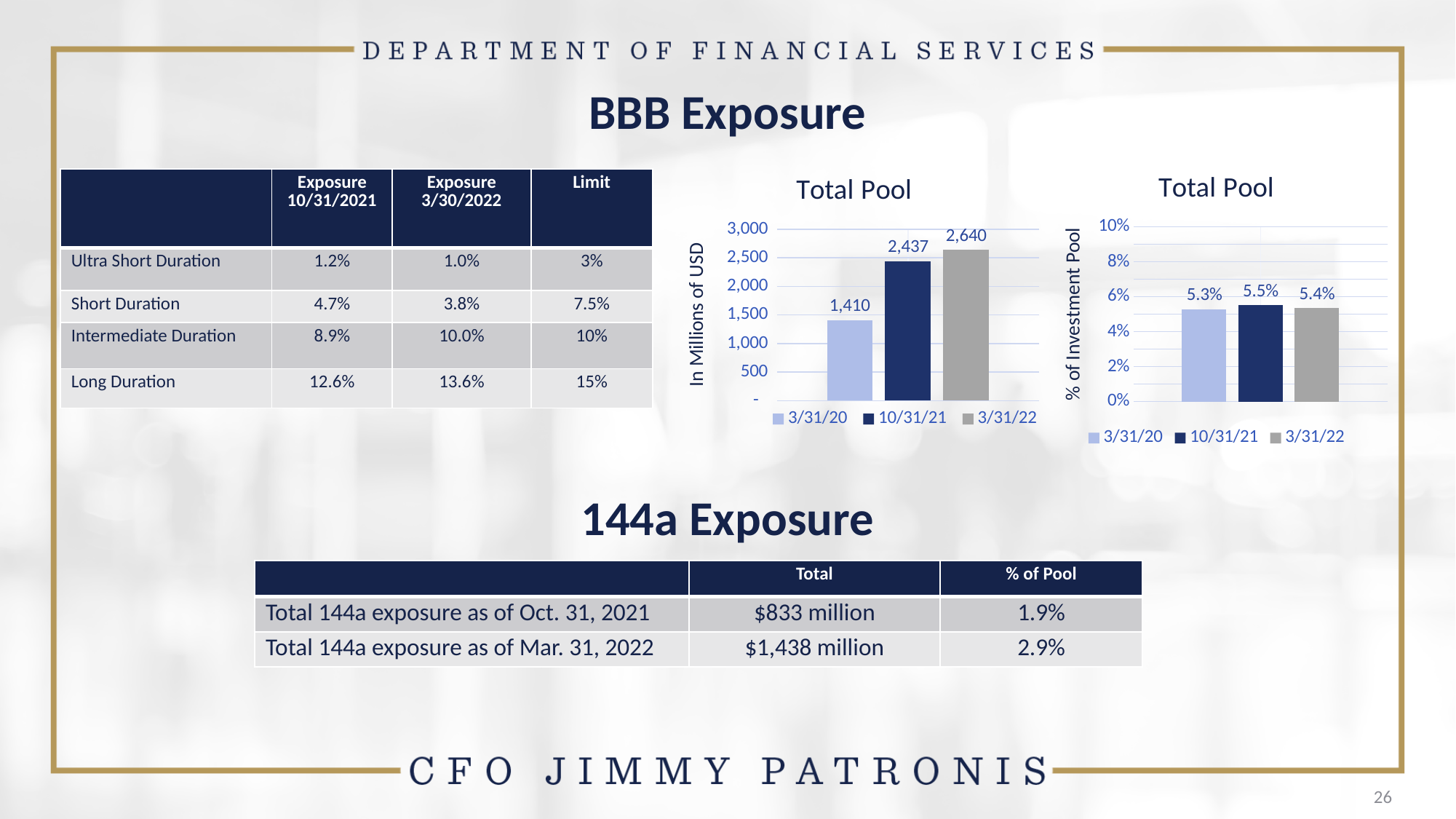
How many bars are plotted in the right 'Total Pool' chart (% of Investment Pool)? 3 How many entries does the legend of the left 'Total Pool' chart (In Millions of USD) list? 3 In the left 'Total Pool' chart (In Millions of USD), which date has the lowest value? 3/31/20 In the right 'Total Pool' chart (% of Investment Pool), what is the difference between the 10/31/21 and 3/31/22 values? 0.1% In the left 'Total Pool' chart (In Millions of USD), what is the difference between the 3/31/22 and 10/31/21 values? 203 In the left 'Total Pool' chart (In Millions of USD), do the values rise or fall from 3/31/20 to 3/31/22? rise What kind of chart is the left 'Total Pool' chart (In Millions of USD)? bar chart In the left 'Total Pool' chart (In Millions of USD), what is the value for 3/31/20? 1,410 In the right 'Total Pool' chart (% of Investment Pool), what is the value for 3/31/20? 5.3% In the left 'Total Pool' chart (In Millions of USD), which date has the highest value? 3/31/22 In the right 'Total Pool' chart (% of Investment Pool), what is the value for 10/31/21? 5.5% In the left 'Total Pool' chart (In Millions of USD), what is the value for 3/31/22? 2,640